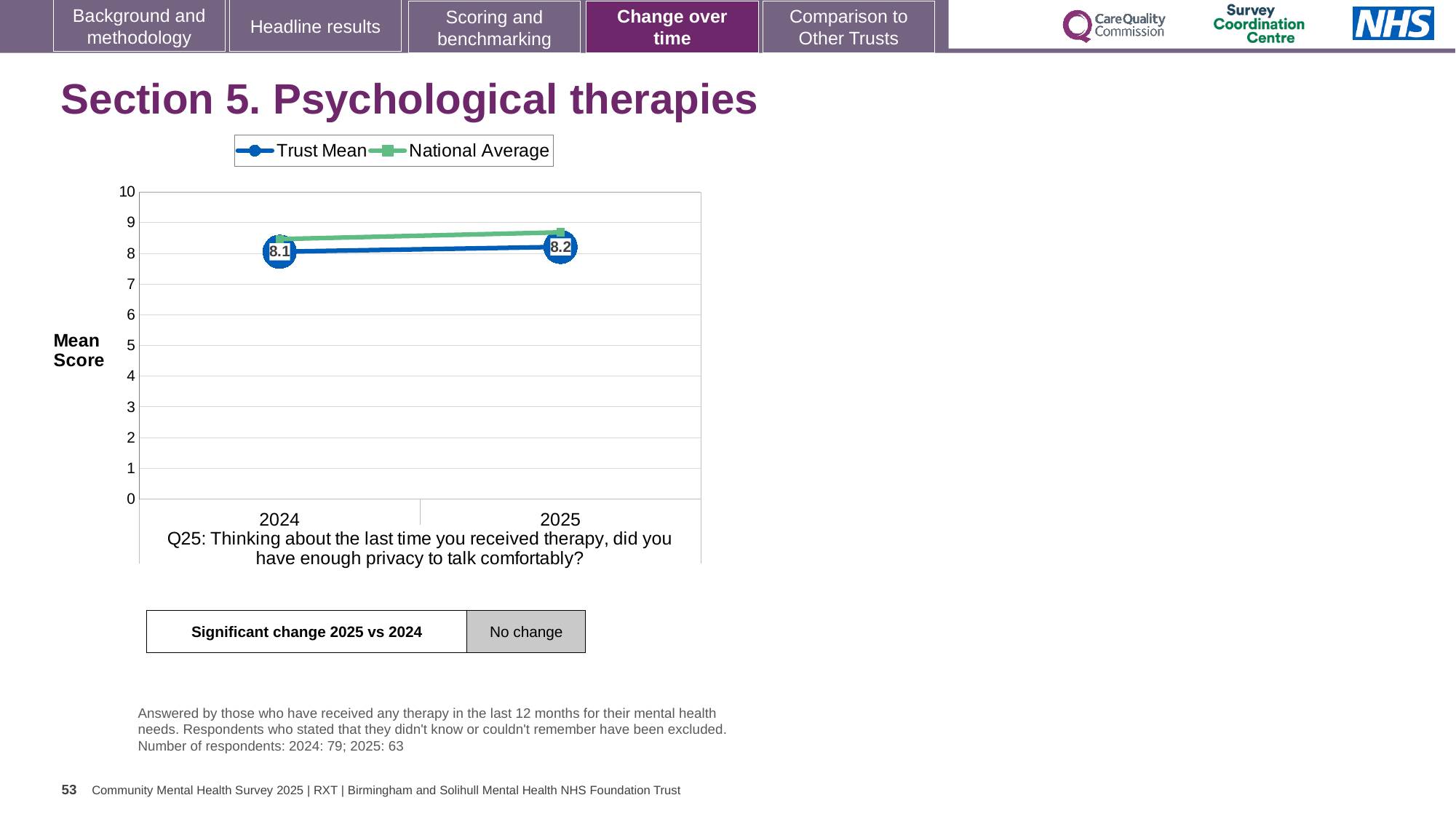
In 2024, which is higher: the Trust Mean or the National Average? National Average Is the National Average value for 2024 greater or less than 8? greater What kind of chart is shown on the slide? line chart How many series does the legend list? 2 In which year is the Trust Mean score higher, 2024 or 2025? 2025 What is the Trust Mean score for 2024? 8.1 What is the difference between the Trust Mean scores for 2025 and 2024? 0.1 What is the Trust Mean score for 2025? 8.2 Is the National Average value for 2025 greater or less than 9? less What is the label of the y axis? Mean Score How many years are plotted on the x axis? 2 Does the Trust Mean rise or fall from 2024 to 2025? rise